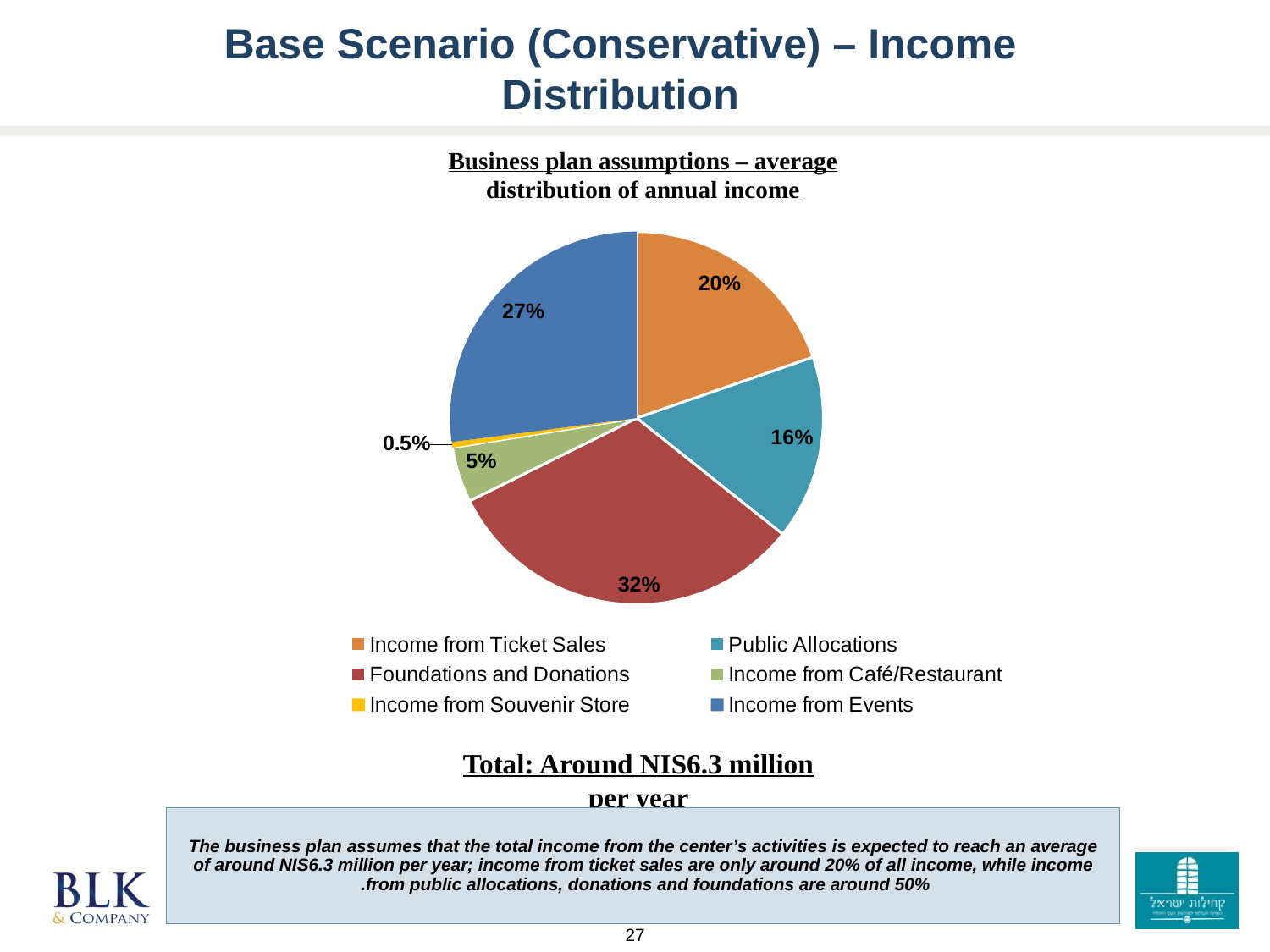
What share of annual income comes from Income from Souvenir Store? 0.5% What share of annual income comes from Foundations and Donations? 32% How many income categories does the legend list? 6 What kind of chart is shown on the slide? Pie chart What share of annual income comes from Income from Ticket Sales? 20% What is the difference in percentage points between Foundations and Donations and Income from Events? 5 What share of annual income comes from Income from Events? 27% Which income source has the largest share of the pie? Foundations and Donations Which income source has the smallest share of the pie? Income from Souvenir Store Which is larger: the share for Income from Ticket Sales or the share for Public Allocations? Income from Ticket Sales What share of annual income comes from Public Allocations? 16% What share of annual income comes from Income from Café/Restaurant? 5%